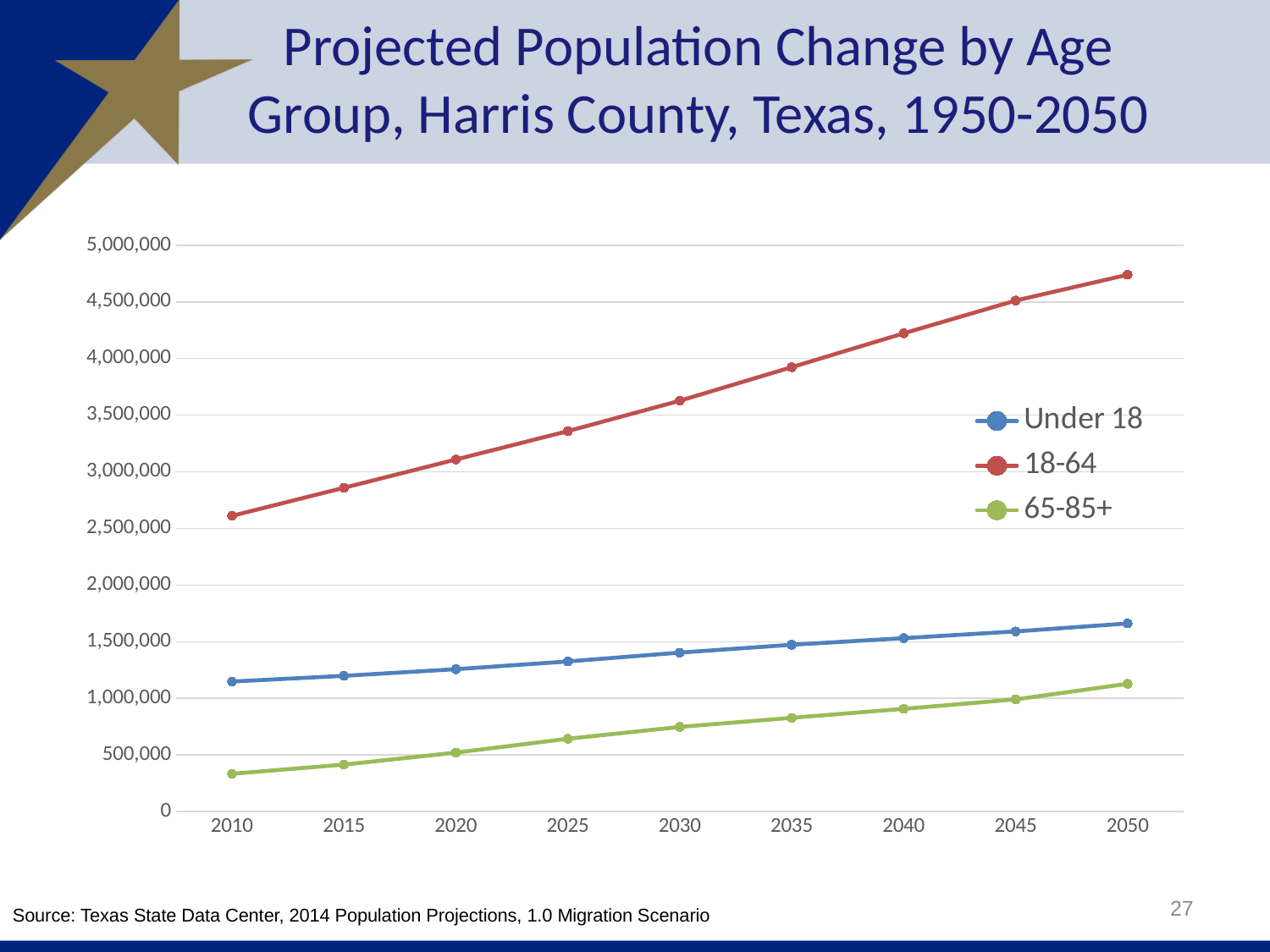
In 2050, which is larger: the Under 18 value or the 65-85+ value? Under 18 How many series does the legend list? 3 Is the value for 65-85+ in 2010 greater or less than 500,000? less Which age group has the highest projected population in 2050? 18-64 Is the value for 18-64 in 2050 greater or less than 4,500,000? greater What kind of chart is shown on the slide? line chart How many years are plotted along the x axis? 9 Which age group has the lowest population in 2010? 65-85+ Is the value for Under 18 in 2050 greater or less than 1,500,000? greater What colour is the line for the 18-64 series? red Does the 65-85+ line rise or fall from 2010 to 2050? rise